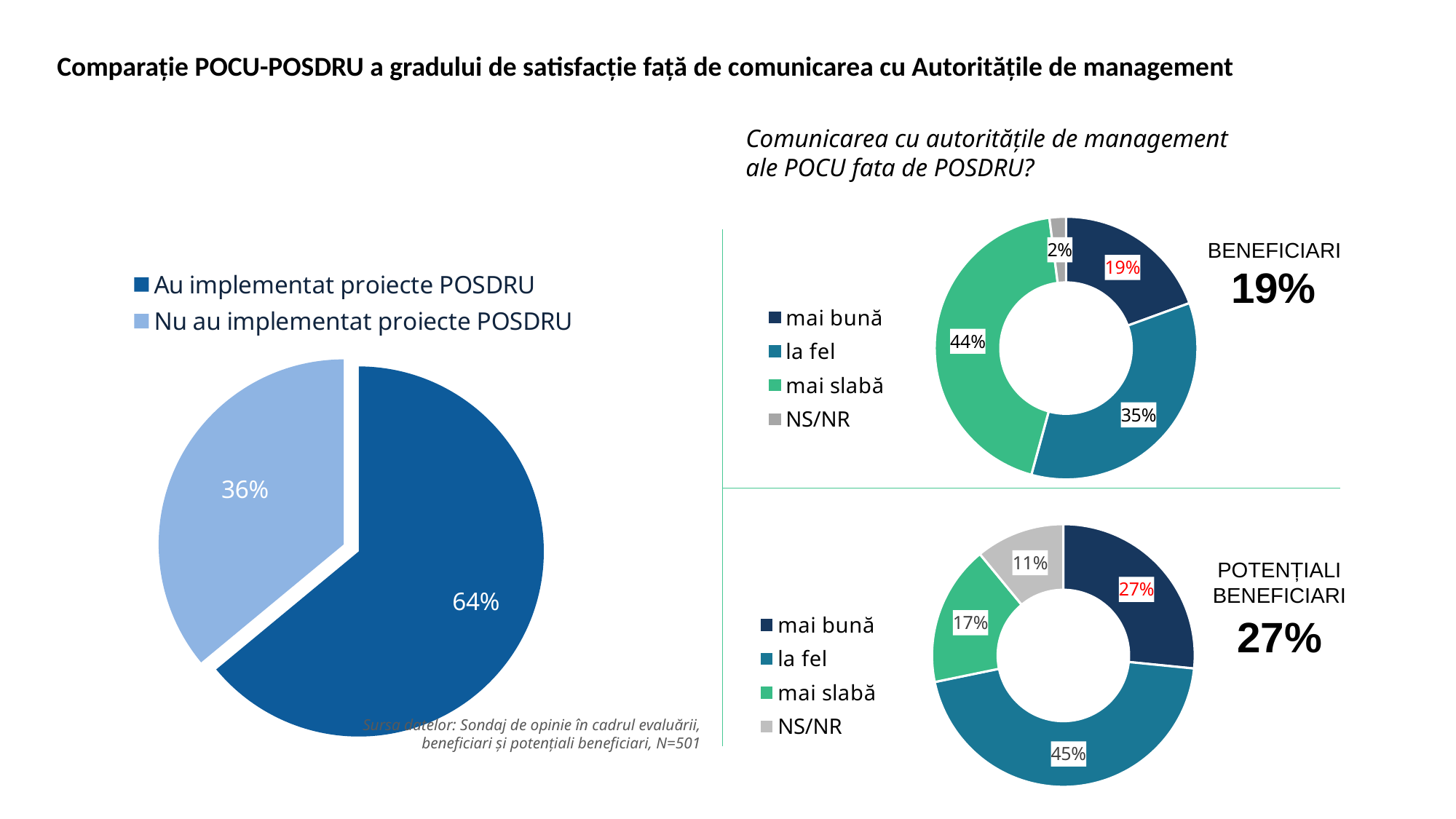
In the BENEFICIARI donut chart, what percentage answered 'mai slabă'? 44% What type of chart is the chart on the left of the slide? Pie chart In the BENEFICIARI donut chart, which category has the smallest share? NS/NR In the pie chart on the left, what is the difference between the 'Au implementat' and 'Nu au implementat' shares? 28 percentage points What is the difference between the 'mai slabă' share for BENEFICIARI and for POTENȚIALI BENEFICIARI? 27 percentage points In the POTENȚIALI BENEFICIARI donut chart, what percentage answered 'la fel'? 45% In the BENEFICIARI donut chart, which category has the largest share? mai slabă In the POTENȚIALI BENEFICIARI donut chart, what percentage answered 'NS/NR'? 11% In the pie chart on the left, what share of respondents have implemented POSDRU projects (Au implementat proiecte POSDRU)? 64% In the pie chart on the left, what share is labelled for 'Nu au implementat proiecte POSDRU'? 36% How many categories does the legend of the POTENȚIALI BENEFICIARI donut chart list? 4 Which is larger: the 'mai bună' share for BENEFICIARI or for POTENȚIALI BENEFICIARI? POTENȚIALI BENEFICIARI